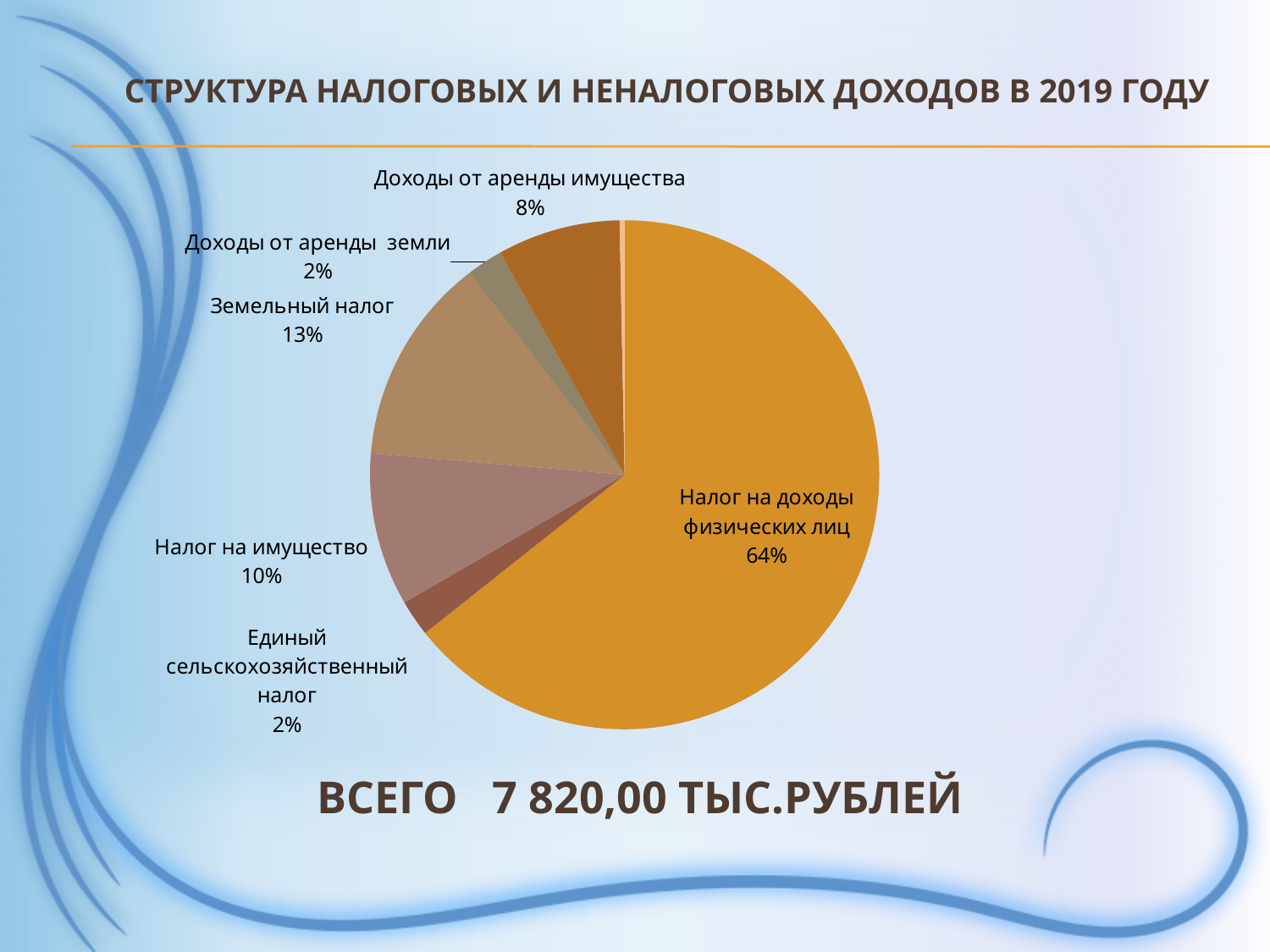
What percentage is shown for Налог на имущество? 10% What total amount is stated below the chart? 7 820,00 тыс.рублей What percentage is shown for Единый сельскохозяйственный налог? 2% Which is larger, Земельный налог or Налог на имущество? Земельный налог What percentage is shown for Доходы от аренды земли? 2% What percentage is shown for Доходы от аренды имущества? 8% What percentage is shown for Земельный налог? 13% What is the title of the slide? СТРУКТУРА НАЛОГОВЫХ И НЕНАЛОГОВЫХ ДОХОДОВ В 2019 ГОДУ Which category has the largest share of the pie? Налог на доходы физических лиц By how many percentage points does Налог на доходы физических лиц exceed Земельный налог? 51 percentage points What share of the pie does Налог на доходы физических лиц represent? 64% What type of chart is shown on the slide? Pie chart